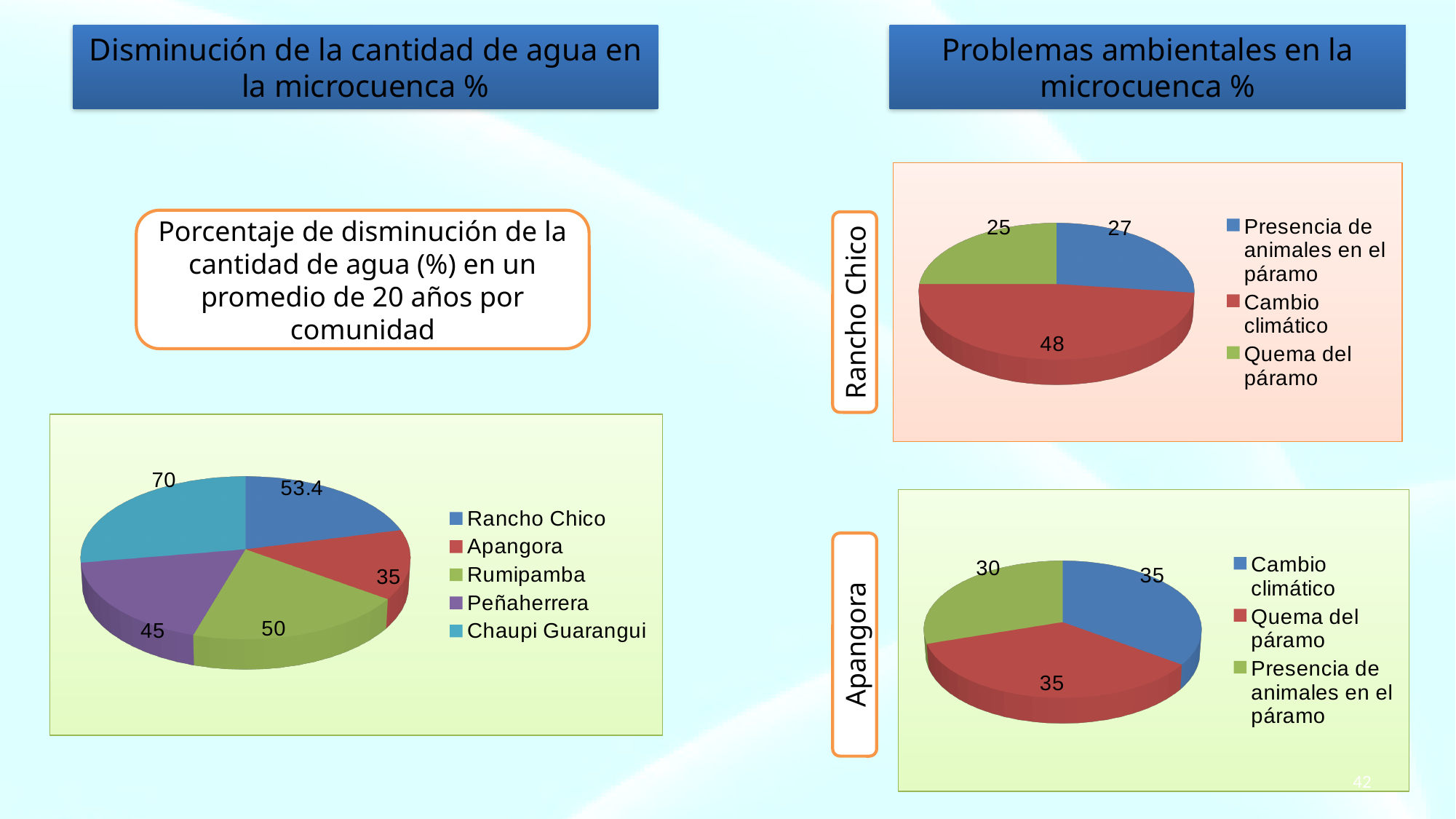
In the Rancho Chico pie chart on environmental problems, which problem has the lowest value? Quema del páramo In the left pie chart on water decrease, what is the value for Rancho Chico? 53.4 In the left pie chart on water decrease, what is the difference between the values for Rumipamba and Peñaherrera? 5 In the left pie chart on water decrease, which community has the lowest value? Apangora In the Apangora pie chart on environmental problems, what is the value for Presencia de animales en el páramo? 30 In the left pie chart on water decrease, which community has the highest value? Chaupi Guarangui In the Rancho Chico pie chart on environmental problems, what is the value for Cambio climático? 48 What type of chart is used for the Apangora environmental problems chart? Pie chart In the Rancho Chico pie chart on environmental problems, what is the difference between Cambio climático and Presencia de animales en el páramo? 21 In the left pie chart on water decrease, how many communities are shown? 5 In the Apangora pie chart on environmental problems, is the value for Cambio climático larger or smaller than the value for Presencia de animales en el páramo? larger In the left pie chart on water decrease, what is the value for Chaupi Guarangui? 70